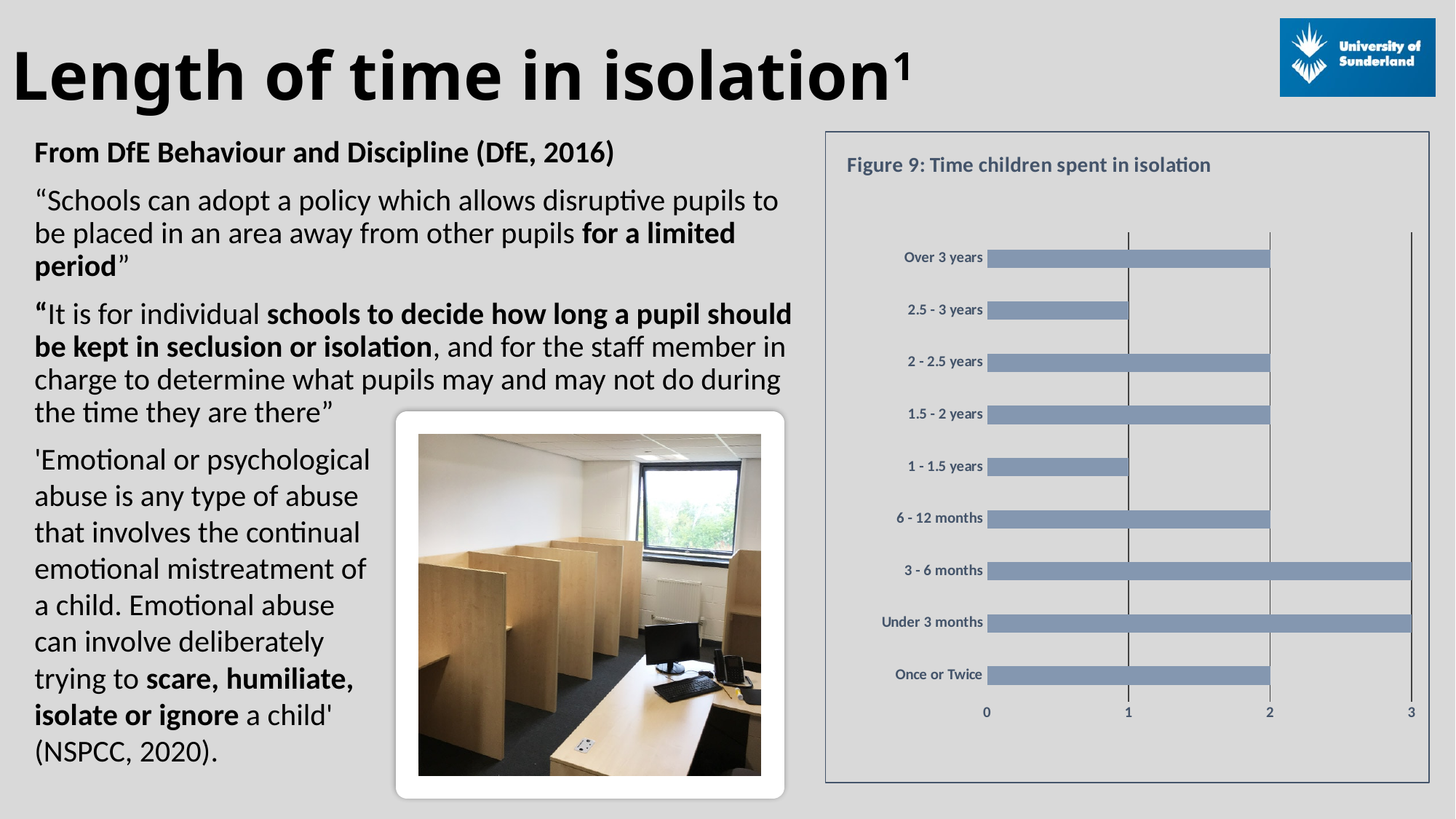
Is the value for 'Once or Twice' greater or less than 1? greater What is the value for '3 - 6 months'? 3 Which is larger, the value for '3 - 6 months' or the value for '1 - 1.5 years'? 3 - 6 months What is the value for 'Over 3 years'? 2 What is the value for '2.5 - 3 years'? 1 What is the difference between the values for 'Under 3 months' and '2.5 - 3 years'? 2 What is the value for '1 - 1.5 years'? 1 What is the value for 'Under 3 months'? 3 What kind of chart is Figure 9? Bar chart What is the title of the chart? Figure 9: Time children spent in isolation Which is larger, the value for '6 - 12 months' or the value for '2.5 - 3 years'? 6 - 12 months How many categories are shown in the chart? 9